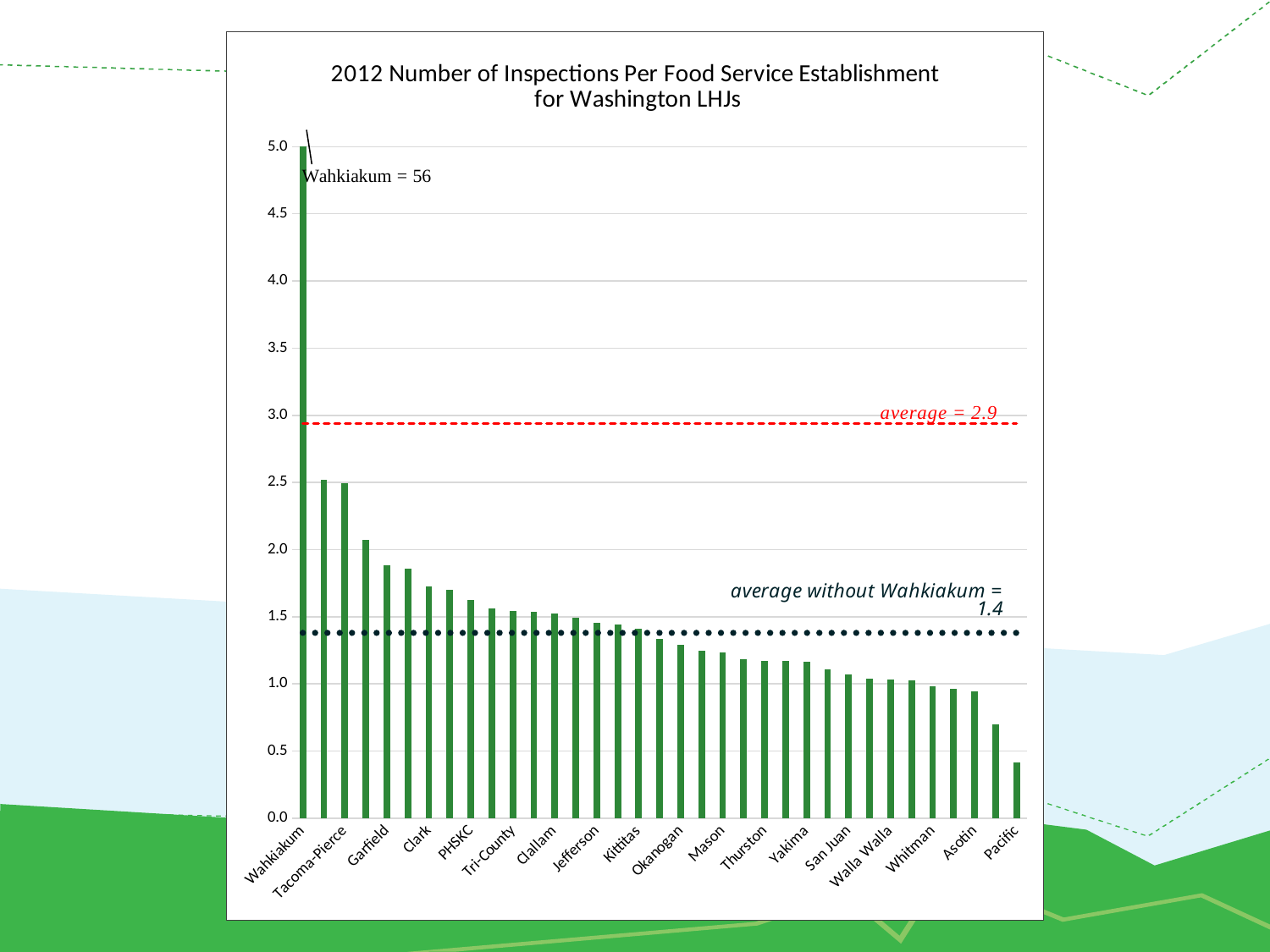
Is the value for Garfield greater or less than 1.5? greater Which has a larger value, Tacoma-Pierce or Clark? Tacoma-Pierce Which LHJ has the lowest number of inspections per food service establishment? Pacific What is the title of the chart? 2012 Number of Inspections Per Food Service Establishment for Washington LHJs Is the value for Okanogan greater or less than 1.5? less What kind of chart is shown on the slide? bar chart What is the average shown by the red dashed line? 2.9 Is the value for Tacoma-Pierce greater or less than 2.0? greater What value is given for Wahkiakum in the chart annotation? 56 What is the average without Wahkiakum shown by the dotted line? 1.4 Which LHJ has the highest number of inspections per food service establishment? Wahkiakum Do the bar values rise or fall from left to right along the x axis? fall